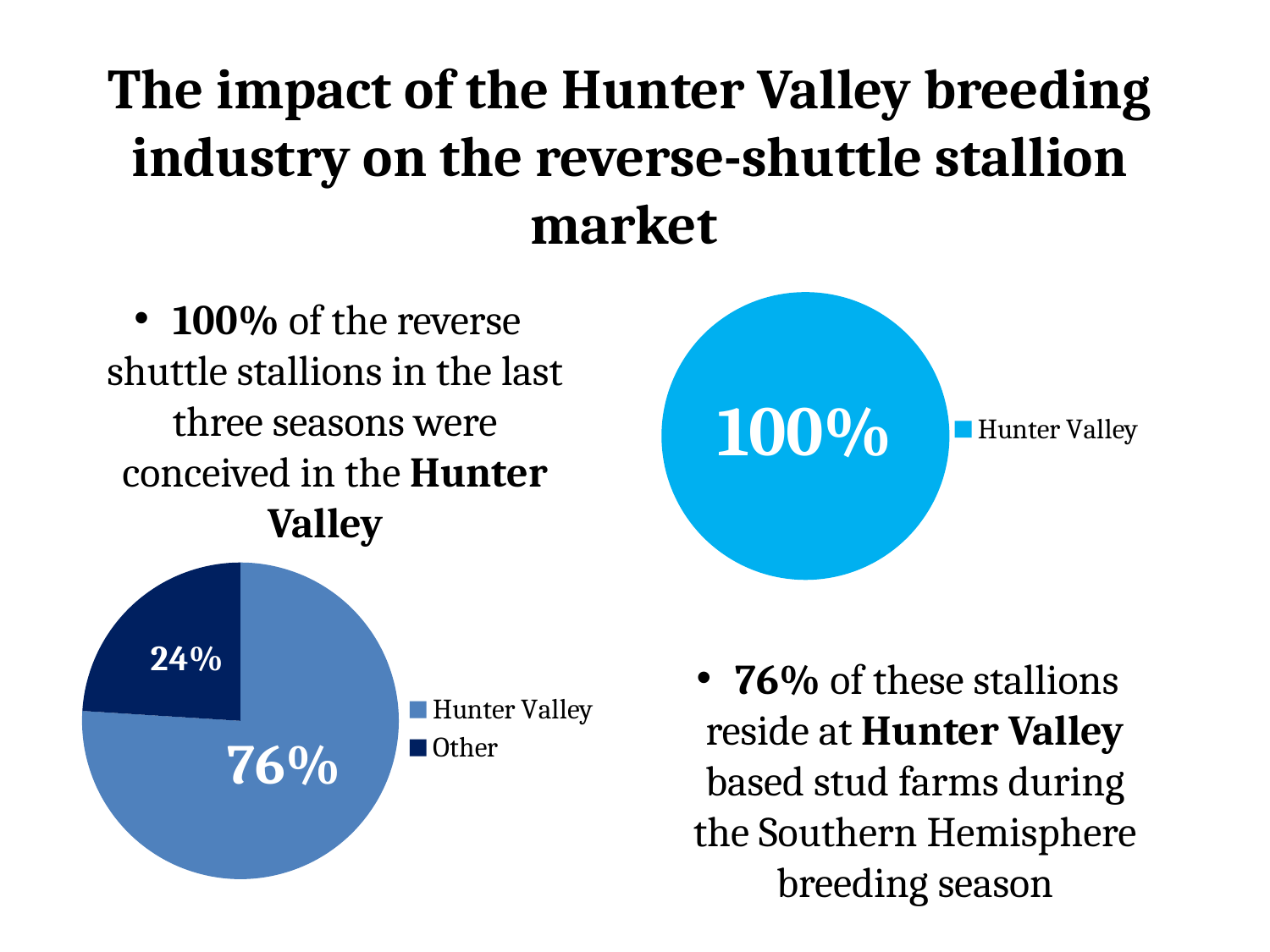
In the lower-left pie chart, what share does Hunter Valley have? 76% In the upper-right pie chart, what share does Hunter Valley have? 100% In the lower-left pie chart, what share does Other have? 24% In the lower-left pie chart, what colour is the Other slice? dark navy blue In the lower-left pie chart, which slice is the smallest? Other How many entries does the legend of the upper-right pie chart list? 1 In the lower-left pie chart, what is the difference between the Hunter Valley share and the Other share? 52% In the lower-left pie chart, which slice is the largest? Hunter Valley What kind of chart is the chart on the upper right of the slide? pie chart What kind of chart is the chart on the lower left of the slide? pie chart How many slices does the lower-left pie chart have? 2 In the lower-left pie chart, which is larger: Hunter Valley or Other? Hunter Valley